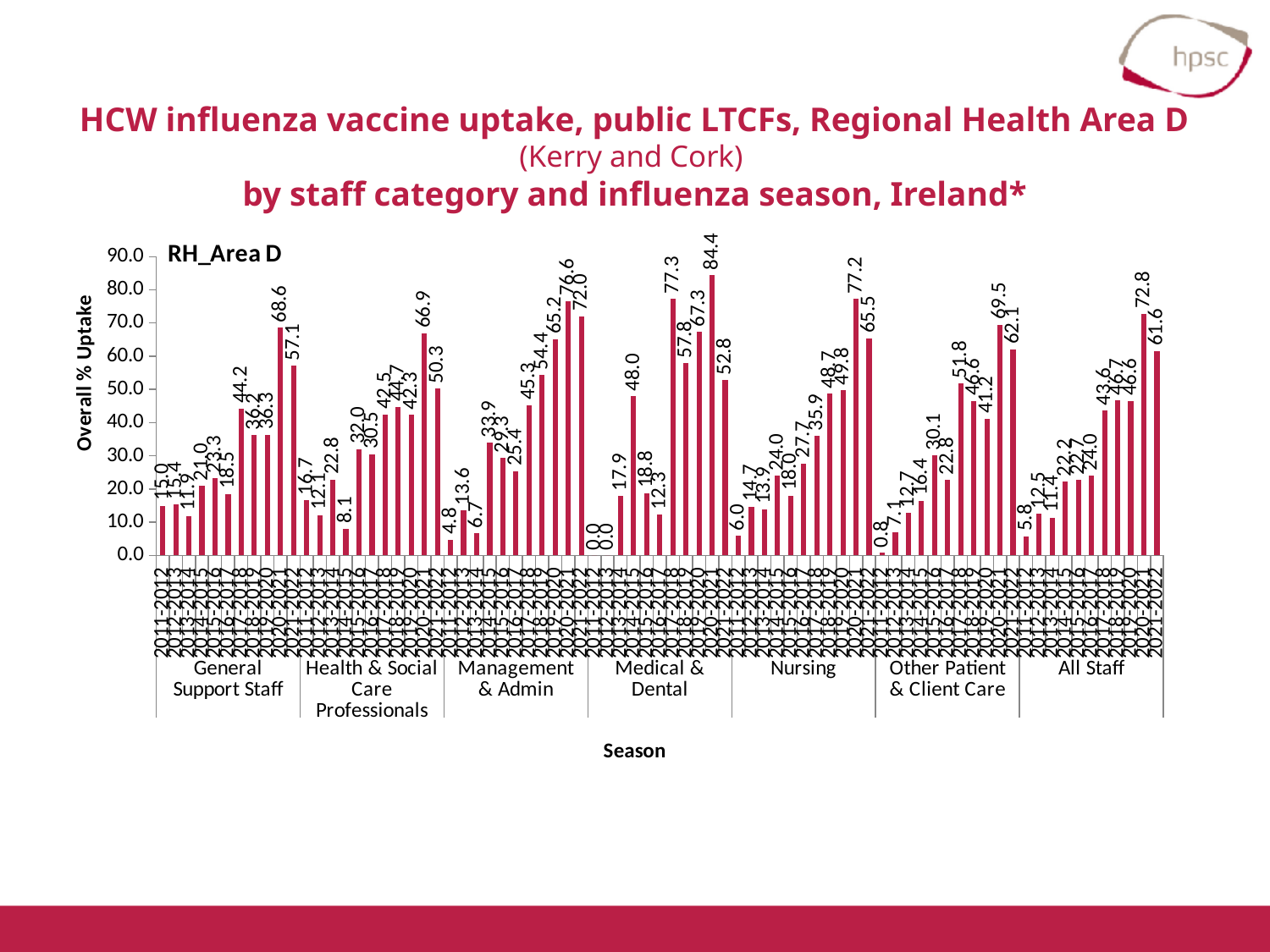
Which is larger: the tallest bar in the Nursing group or the tallest bar in the Health & Social Care Professionals group? Nursing What is the highest value labelled in the Nursing group? 77.2 What is the value for All Staff in the 2020-2021 season (the tallest bar of the All Staff group)? 72.8 What is the label on the vertical axis? Overall % Uptake What type of chart is shown on the slide? bar chart What is the value for All Staff in the 2021-2022 season (the last bar of the All Staff group)? 61.6 What is the highest value labelled in the Medical & Dental group? 84.4 Is the tallest bar in the Other Patient & Client Care group greater or less than 60.0? greater What is the highest value labelled in the General Support Staff group? 68.6 What is the difference between the All Staff values for 2020-2021 (72.8) and 2021-2022 (61.6)? 11.2 How many staff category groups are shown along the x axis? 7